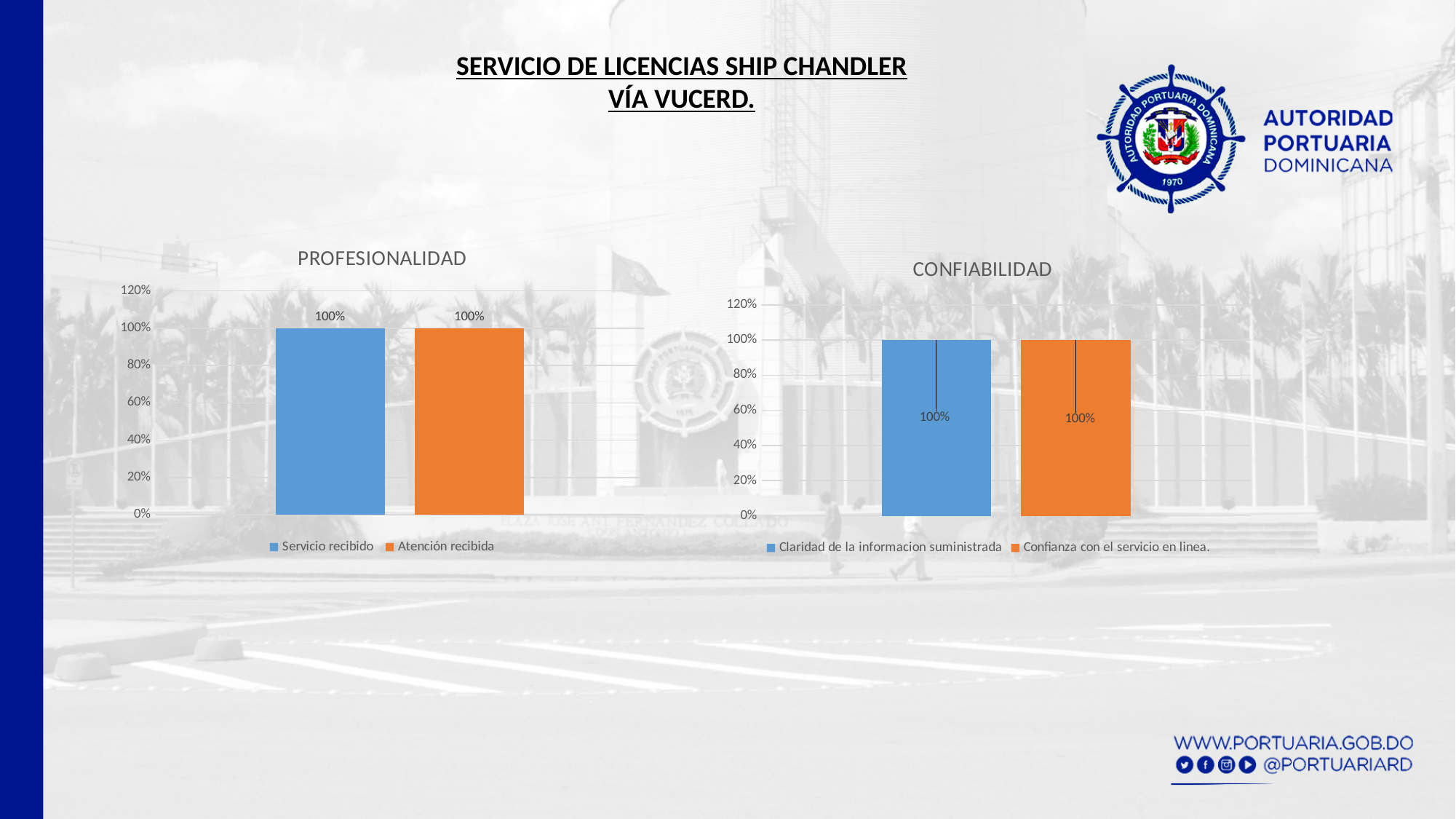
In the CONFIABILIDAD chart, is the value for Confianza con el servicio en linea. greater or less than 120%? less How many series does the legend of the PROFESIONALIDAD chart list? 2 In the CONFIABILIDAD chart, what is the difference between Claridad de la informacion suministrada and Confianza con el servicio en linea.? 0% In the CONFIABILIDAD chart, what is the value for Confianza con el servicio en linea.? 100% In the PROFESIONALIDAD chart, what is the value for Atención recibida? 100% In the PROFESIONALIDAD chart, what is the difference between Servicio recibido and Atención recibida? 0% In the PROFESIONALIDAD chart, what is the value for Servicio recibido? 100% How many series does the legend of the CONFIABILIDAD chart list? 2 In the PROFESIONALIDAD chart, is the value for Servicio recibido greater or less than 80%? greater What colour is the Atención recibida bar in the PROFESIONALIDAD chart? Orange In the CONFIABILIDAD chart, what is the value for Claridad de la informacion suministrada? 100% What kind of chart is the CONFIABILIDAD chart? Bar chart